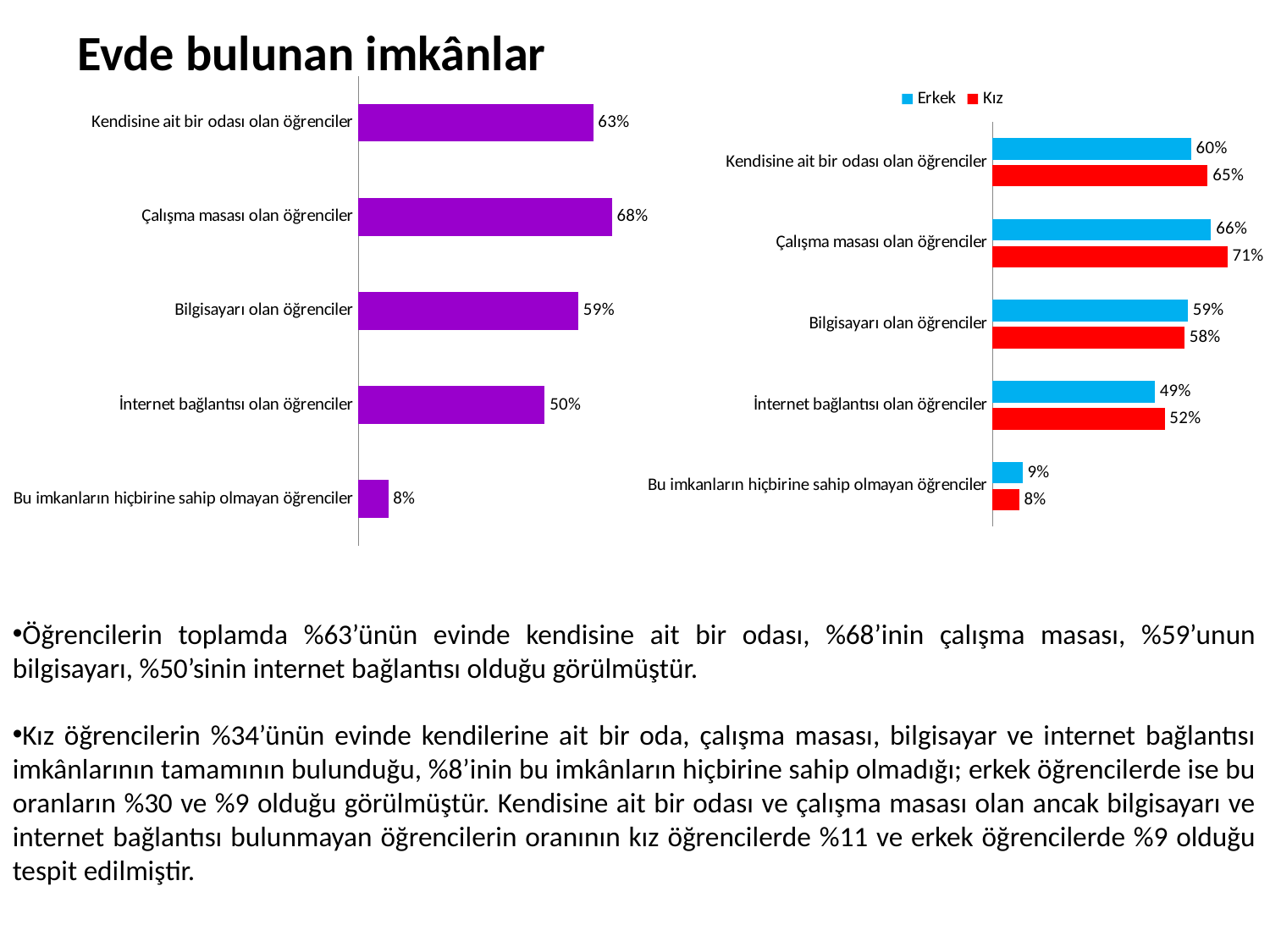
In the right chart, what is the difference between the Kız and Erkek values for Çalışma masası olan öğrenciler? 5% In the right chart, what is the Erkek value for İnternet bağlantısı olan öğrenciler? 49% In the left chart, which category has the lowest value? Bu imkanların hiçbirine sahip olmayan öğrenciler In the left chart, what is the difference between Kendisine ait bir odası olan öğrenciler and İnternet bağlantısı olan öğrenciler? 13% In the right chart, which colour represents the Erkek series? Blue How many series does the legend of the right chart list? 2 How many categories does the left chart show? 5 In the right chart, what is the Kız value for Çalışma masası olan öğrenciler? 71% In the left chart, which category has the highest value? Çalışma masası olan öğrenciler In the left chart, what is the value for Çalışma masası olan öğrenciler? 68% What type of chart is the left chart? Bar chart In the right chart, which is larger for Kendisine ait bir odası olan öğrenciler, Erkek or Kız? Kız